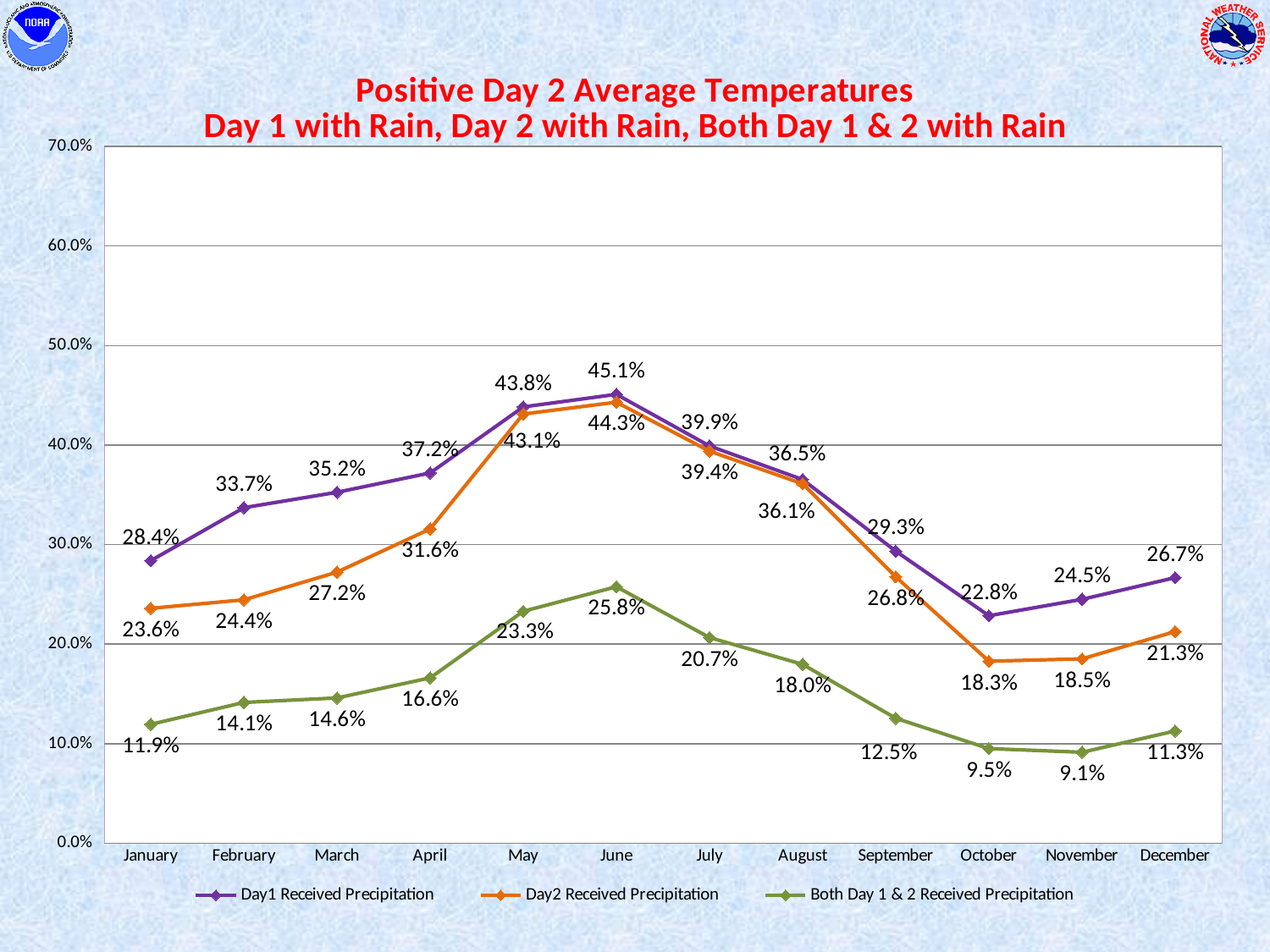
What is the value for Day2 Received Precipitation in April? 31.6% In which month is the Day2 Received Precipitation series highest? June What is the difference between Day1 Received Precipitation and Day2 Received Precipitation in January? 4.8% Does the Day1 Received Precipitation series rise or fall from January to June? Rise How many series does the legend list? 3 In which month is the Both Day 1 & 2 Received Precipitation series lowest? November What is the value for Both Day 1 & 2 Received Precipitation in October? 9.5% How many months are plotted on the x axis? 12 What kind of chart is shown on the slide? Line chart Which is larger in December: Day1 Received Precipitation or Both Day 1 & 2 Received Precipitation? Day1 Received Precipitation What is the value for Day1 Received Precipitation in June? 45.1% Which colour is used for the Both Day 1 & 2 Received Precipitation series? Green